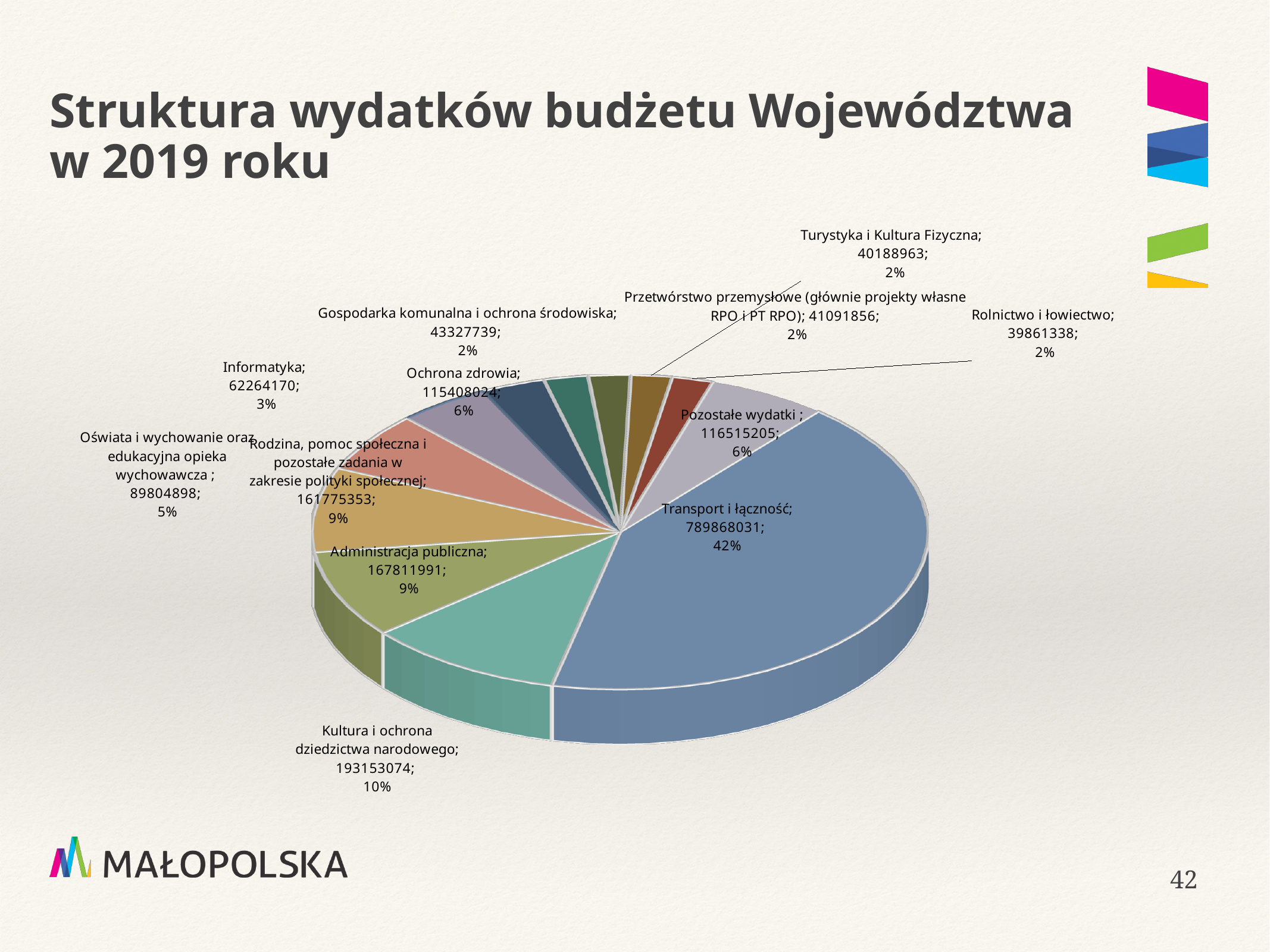
What is the value for Informatyka? 62264170 What is the value for Rolnictwo i łowiectwo? 39861338 What is the value for Kultura i ochrona dziedzictwa narodowego? 193153074 What share of the pie does Ochrona zdrowia represent? 6% Which category has the smallest value? Rolnictwo i łowiectwo What type of chart is shown on the slide? pie chart Which is larger, the value for Administracja publiczna or the value for Rodzina, pomoc społeczna i pozostałe zadania w zakresie polityki społecznej? Administracja publiczna What is the value for Transport i łączność? 789868031 Which category has the largest share of the pie? Transport i łączność How many slices does the pie chart have? 12 What is the difference between the values for Transport i łączność and Kultura i ochrona dziedzictwa narodowego? 596714957 What share of the pie does Kultura i ochrona dziedzictwa narodowego represent? 10%